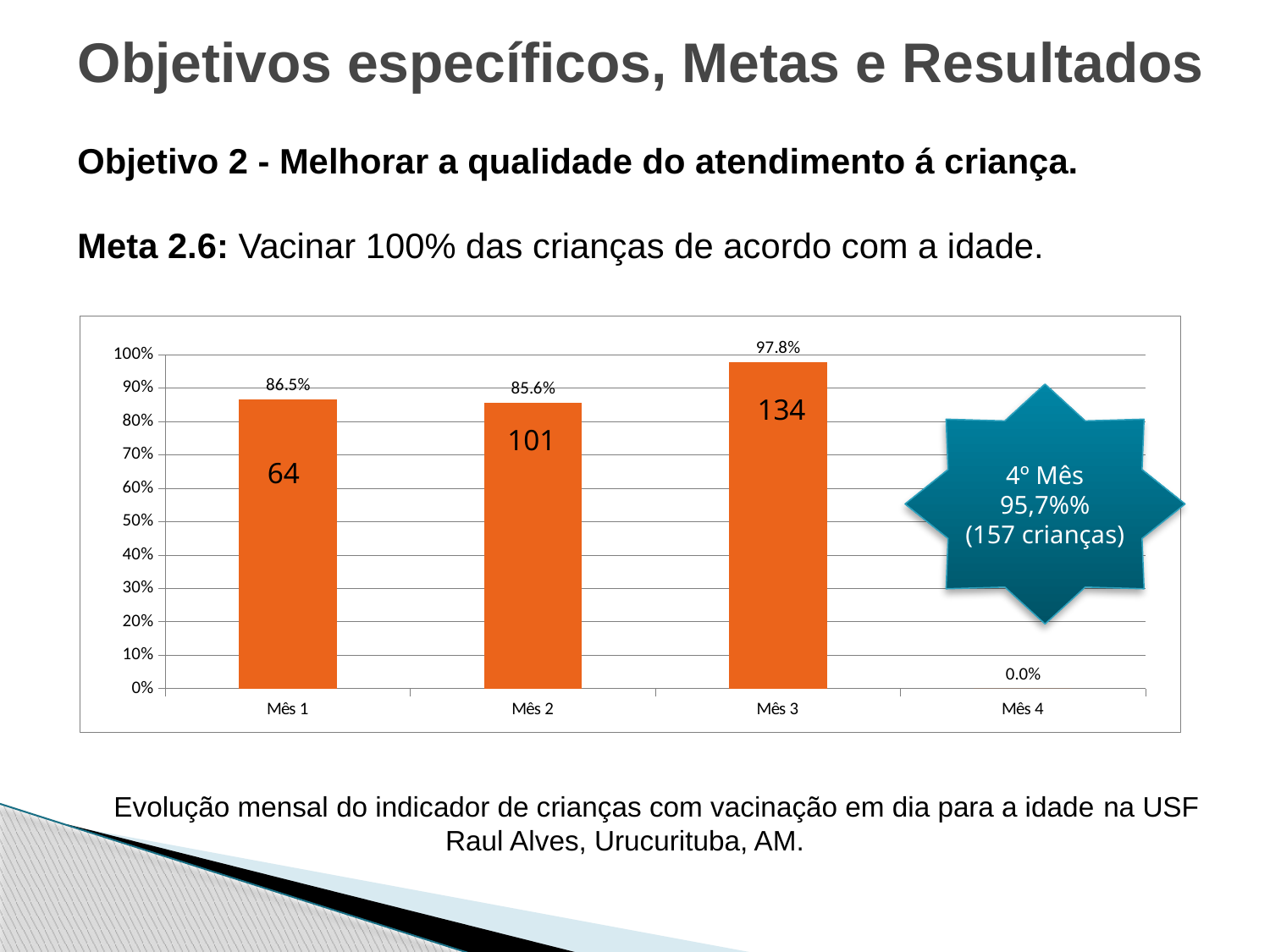
Which month has the lowest percentage on the chart? Mês 4 What kind of chart is shown on the slide? Bar chart What is the value shown for Mês 3? 97.8% How many categories are shown on the x axis of the chart? 4 Which month has the highest percentage on the chart? Mês 3 What is the value shown for Mês 1? 86.5% What number is printed inside the bar for Mês 1? 64 Which is larger, the value for Mês 1 or the value for Mês 2? Mês 1 What number is printed inside the bar for Mês 3? 134 What is the value shown for Mês 2? 85.6% What is the difference between the percentages for Mês 3 and Mês 1? 11.3% What is the value shown for Mês 4 on the chart? 0.0%